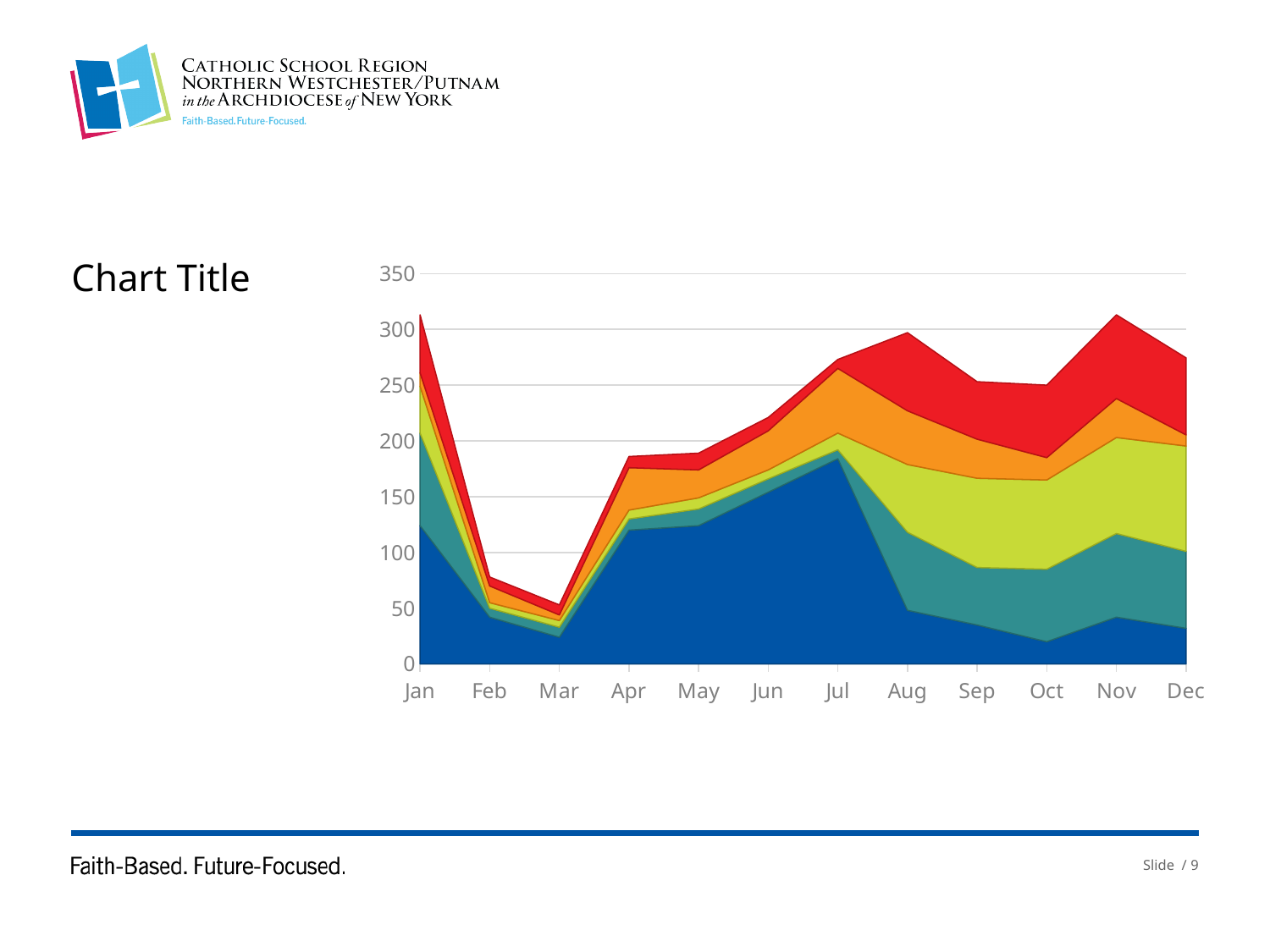
Is the value of the bottom dark blue series for Oct greater or less than 50? less Which month has the lowest stacked total in the chart? Mar Which month has the larger stacked total, Aug or Sep? Aug Is the stacked total for Aug greater or less than 250? greater Is the value of the bottom dark blue series for Jul greater or less than 150? greater What kind of chart is shown on the slide? Stacked area chart How many months are shown along the x axis of the chart? 12 What is the title of the chart? Chart Title Does the stacked total rise or fall from Mar to Jul? rise How many coloured bands are stacked in the chart? 5